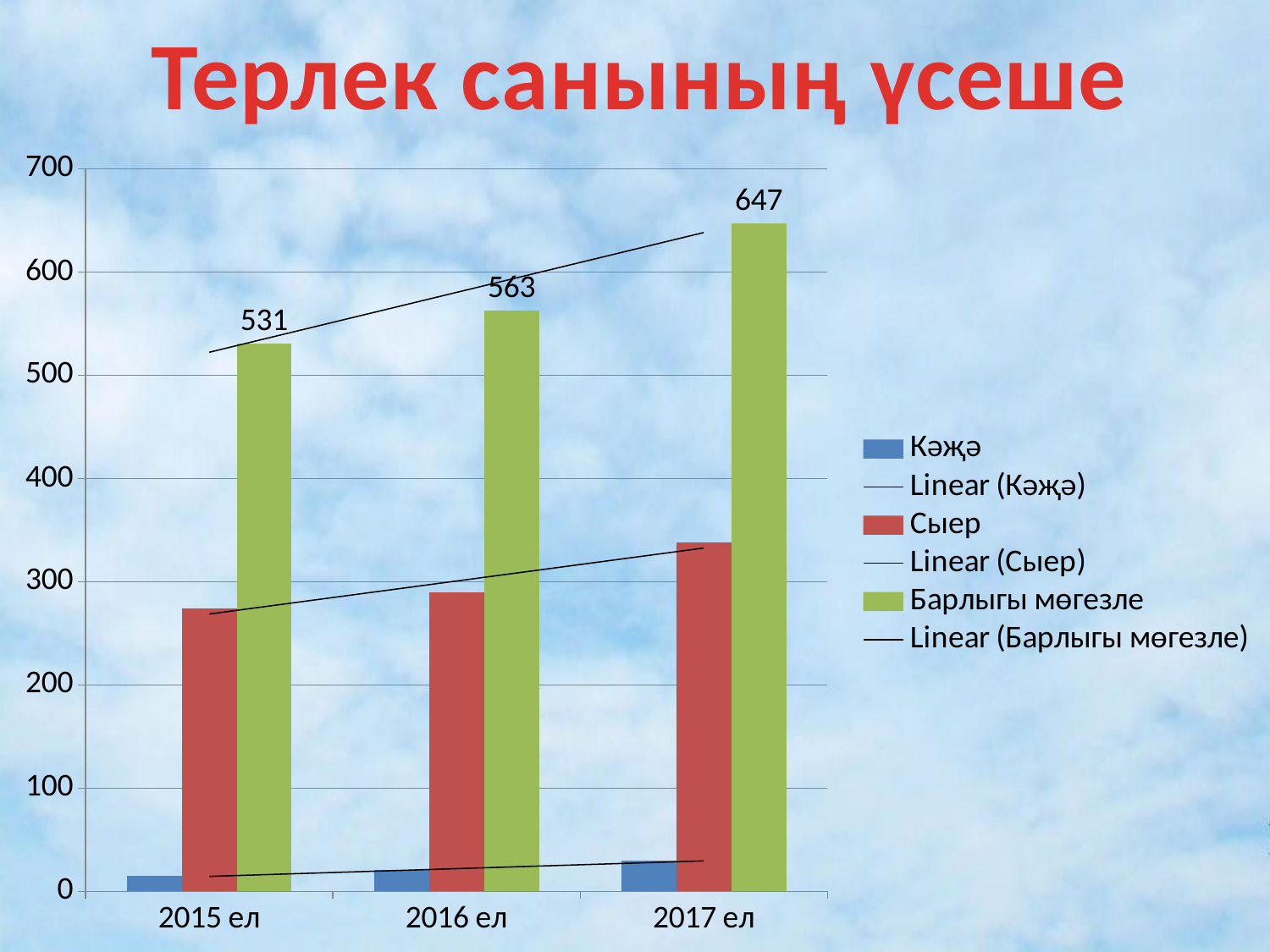
Do the Барлыгы мөгезле values rise or fall from 2015 ел to 2017 ел? rise Which is larger: the Барлыгы мөгезле value for 2016 ел or for 2015 ел? 2016 ел What is the value for Барлыгы мөгезле in 2017 ел? 647 What is the value for Барлыгы мөгезле in 2016 ел? 563 Is the value for Сыер in 2015 ел greater or less than 300? less What is the difference between the Барлыгы мөгезле values for 2017 ел and 2015 ел? 116 What is the value for Барлыгы мөгезле in 2015 ел? 531 In which year is the Барлыгы мөгезле value lowest? 2015 ел How many years are shown on the x axis? 3 Is the value for Сыер in 2017 ел greater or less than 300? greater In which year is the Барлыгы мөгезле value highest? 2017 ел How many entries does the legend list? 6